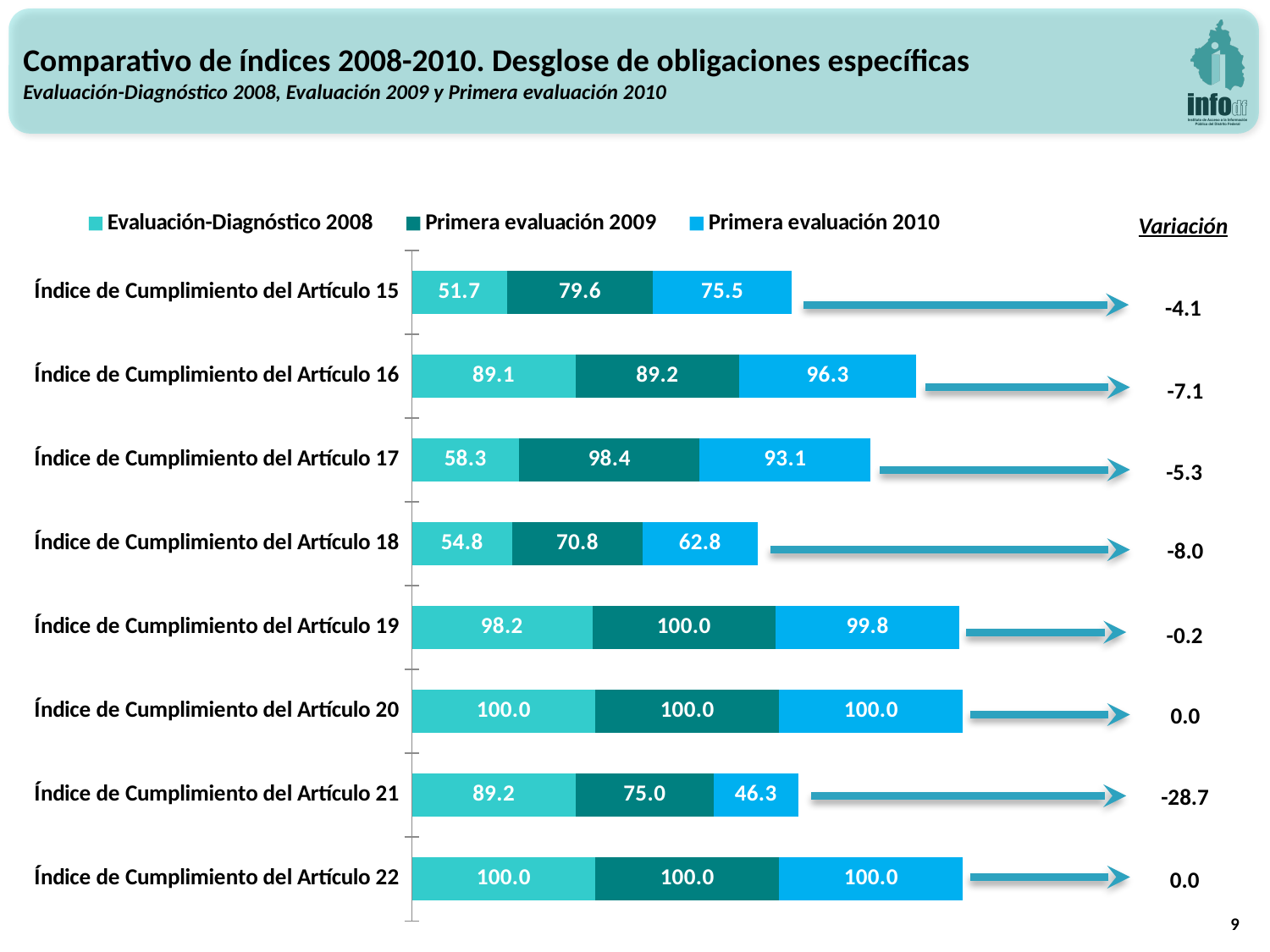
For Índice de Cumplimiento del Artículo 15, how much higher is the Primera evaluación 2009 value than the Evaluación-Diagnóstico 2008 value? 27.9 How many series does the legend list? 3 What kind of chart is shown on the slide? Stacked bar chart Which category has the lowest Evaluación-Diagnóstico 2008 value? Índice de Cumplimiento del Artículo 15 Which category has the lowest Primera evaluación 2010 value? Índice de Cumplimiento del Artículo 21 Which is larger: the Primera evaluación 2010 value for Artículo 16 or for Artículo 17? Artículo 16 What is the total of the stacked bar for Índice de Cumplimiento del Artículo 18? 188.4 What is the Evaluación-Diagnóstico 2008 value for Índice de Cumplimiento del Artículo 18? 54.8 What is the Primera evaluación 2009 value for Índice de Cumplimiento del Artículo 17? 98.4 What is the Primera evaluación 2010 value for Índice de Cumplimiento del Artículo 21? 46.3 For Índice de Cumplimiento del Artículo 21, what is the difference between the Primera evaluación 2009 value and the Primera evaluación 2010 value? 28.7 How many categories (índices) are shown in the chart? 8